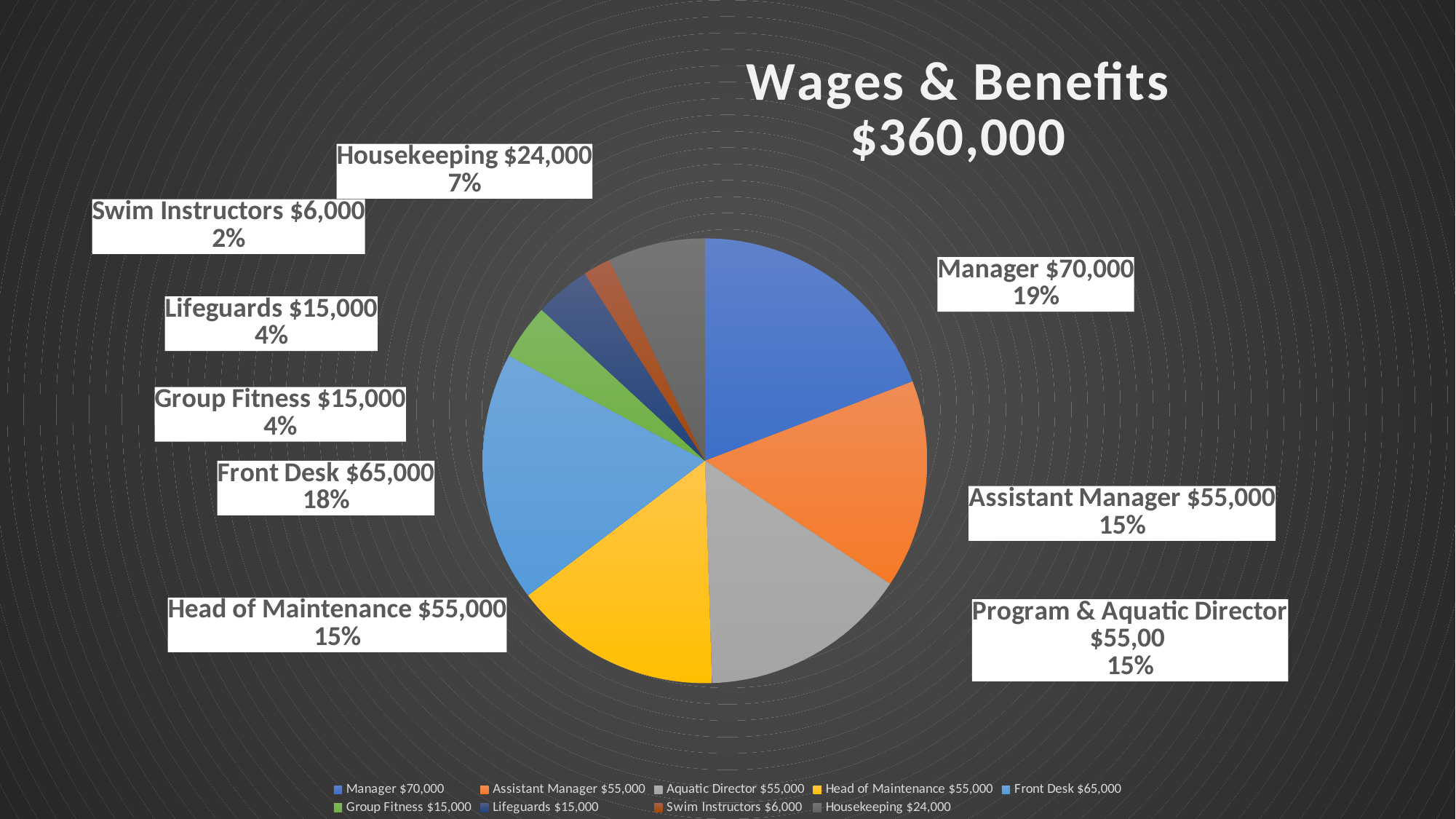
What is the wage value shown for Front Desk? $65,000 Which category has the smallest share of the pie? Swim Instructors How many slices does the pie chart have? 9 What percentage of the pie does Assistant Manager represent? 15% What is the difference in dollars between the Manager value and the Front Desk value? $5,000 What kind of chart is shown on the slide? Pie chart What is the wage value shown for Lifeguards? $15,000 What percentage of the pie does Housekeeping represent? 7% What is the title of the chart? Wages & Benefits $360,000 Which is larger, the Manager slice or the Front Desk slice? Manager Which category has the largest share of the pie? Manager What colour is the Head of Maintenance slice? Yellow